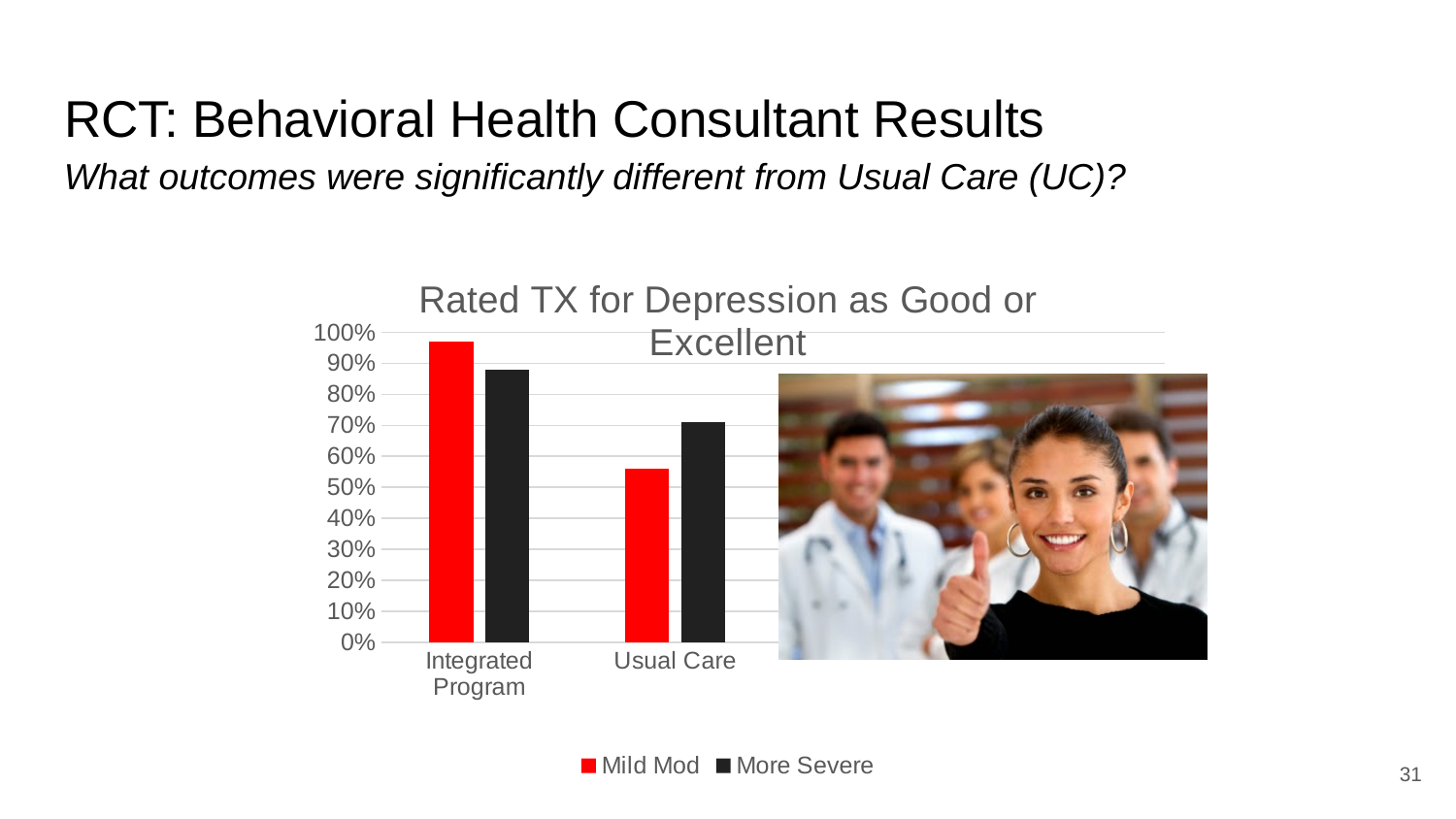
Is the More Severe value for Usual Care greater or less than 60%? greater How many categories are shown on the x axis of the chart? 2 For Usual Care, which series has the larger value, Mild Mod or More Severe? More Severe Which series is shown in red in the chart? Mild Mod Is the Mild Mod value for Integrated Program greater or less than 90%? greater How many series does the chart legend list? 2 For Integrated Program, which series has the larger value, Mild Mod or More Severe? Mild Mod Which category has the lowest More Severe value? Usual Care What type of chart is shown on the slide? bar chart What is the title of the chart? Rated TX for Depression as Good or Excellent Which category has the highest Mild Mod value? Integrated Program Is the Mild Mod value for Usual Care greater or less than 60%? less